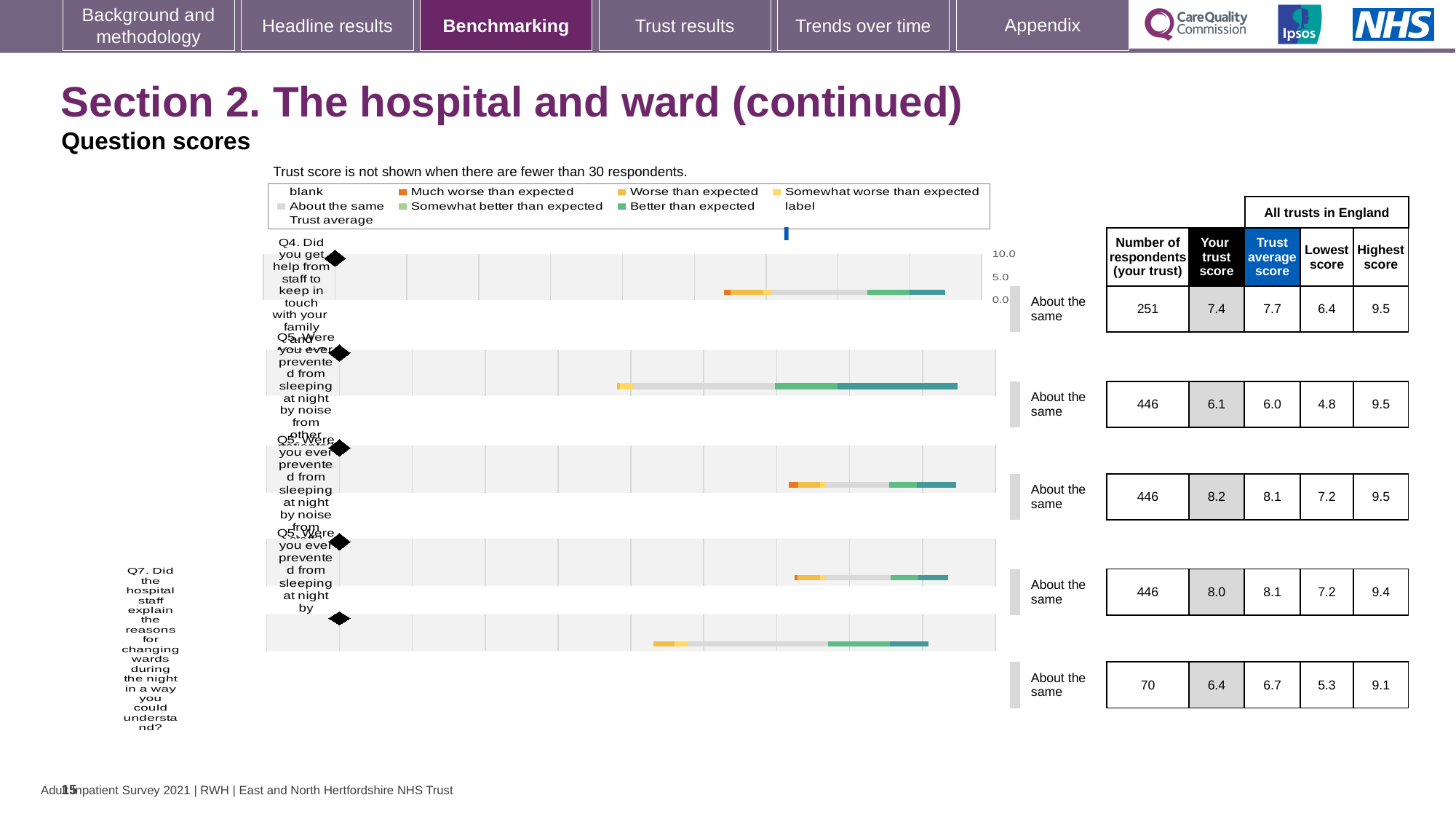
What is the lowest score among all trusts in England for Q7? 5.3 For Q4, what is the difference between the highest score and the lowest score across all trusts in England? 3.1 How many respondents from your trust answered Q4 (help from staff to keep in touch with family and friends)? 251 What kind of chart is used to show the question scores on this slide? Bar chart How many question rows are shown in the benchmarking table on this slide? 5 What benchmark category is shown for Q4 on this slide? About the same How many respondents from your trust answered Q7 (explaining reasons for changing wards during the night)? 70 What is your trust score for Q4 (help from staff to keep in touch with family and friends)? 7.4 For Q4, which is larger: your trust score or the trust average score? Trust average score What is the highest score among all trusts in England for Q4? 9.5 What is the trust average score across all trusts in England for Q4? 7.7 What is your trust score for Q7 (explaining reasons for changing wards during the night)? 6.4